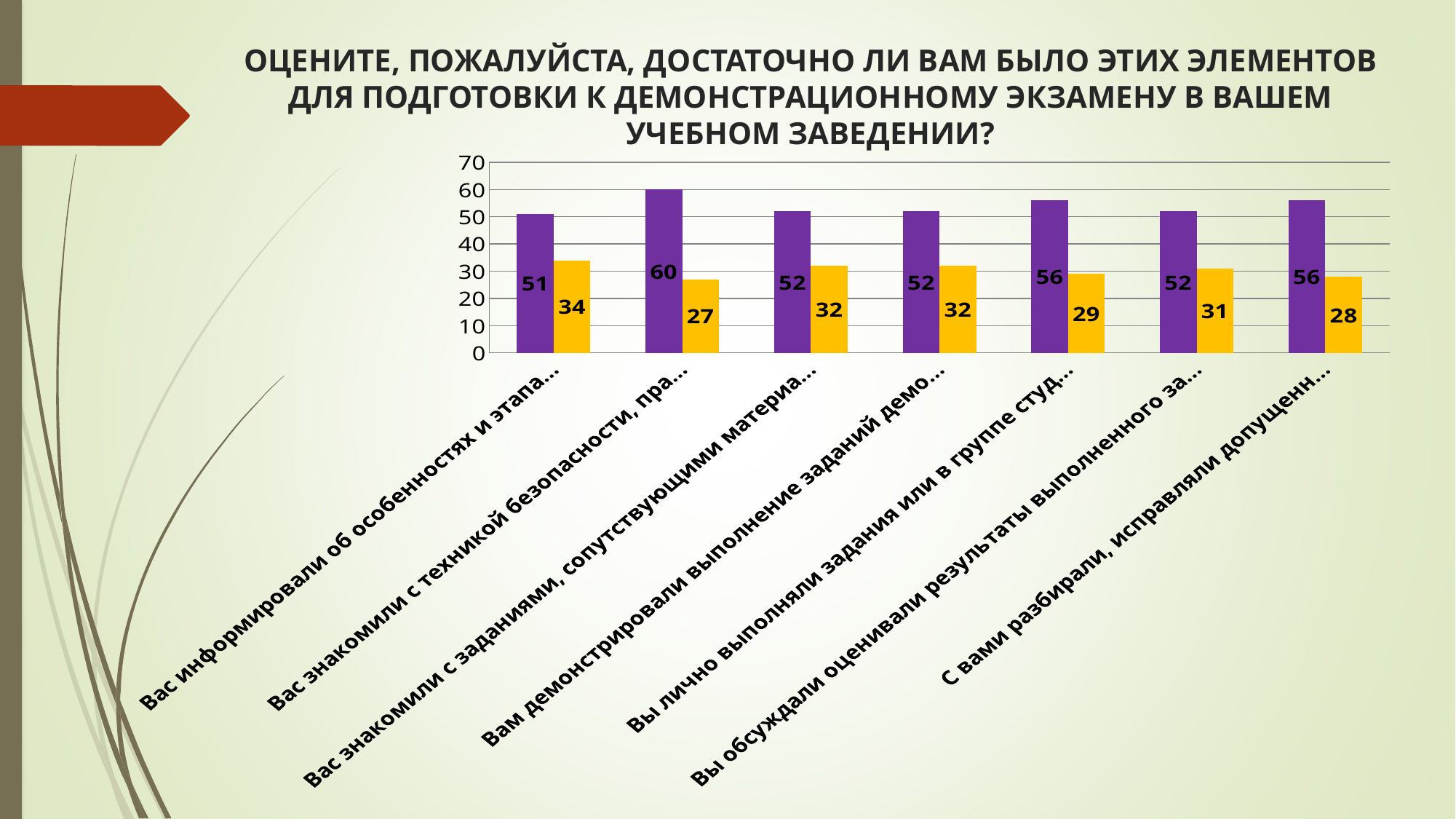
What type of chart is shown on the slide? bar chart Is the value of the purple bar for the category beginning 'Вас информировали об особенностях' greater or less than 40? greater How many categories are shown on the x axis of the chart? 7 What is the value of the purple bar for the category beginning 'Вас знакомили с техникой безопасности'? 60 What is the highest value shown on the vertical axis of the chart? 70 Which category has the highest purple bar? Вас знакомили с техникой безопасности, пра... What is the difference between the purple and yellow bars for the category beginning 'Вас знакомили с техникой безопасности'? 33 What is the value of the yellow bar for the category beginning 'С вами разбирали, исправляли допущенн'? 28 Which category has the lowest yellow bar? Вас знакомили с техникой безопасности, пра... What is the value of the purple bar for the category beginning 'Вы лично выполняли задания'? 56 For the category beginning 'Вам демонстрировали выполнение заданий', which bar is larger, the purple or the yellow? purple What is the value of the yellow bar for the category beginning 'Вас информировали об особенностях и этапа'? 34